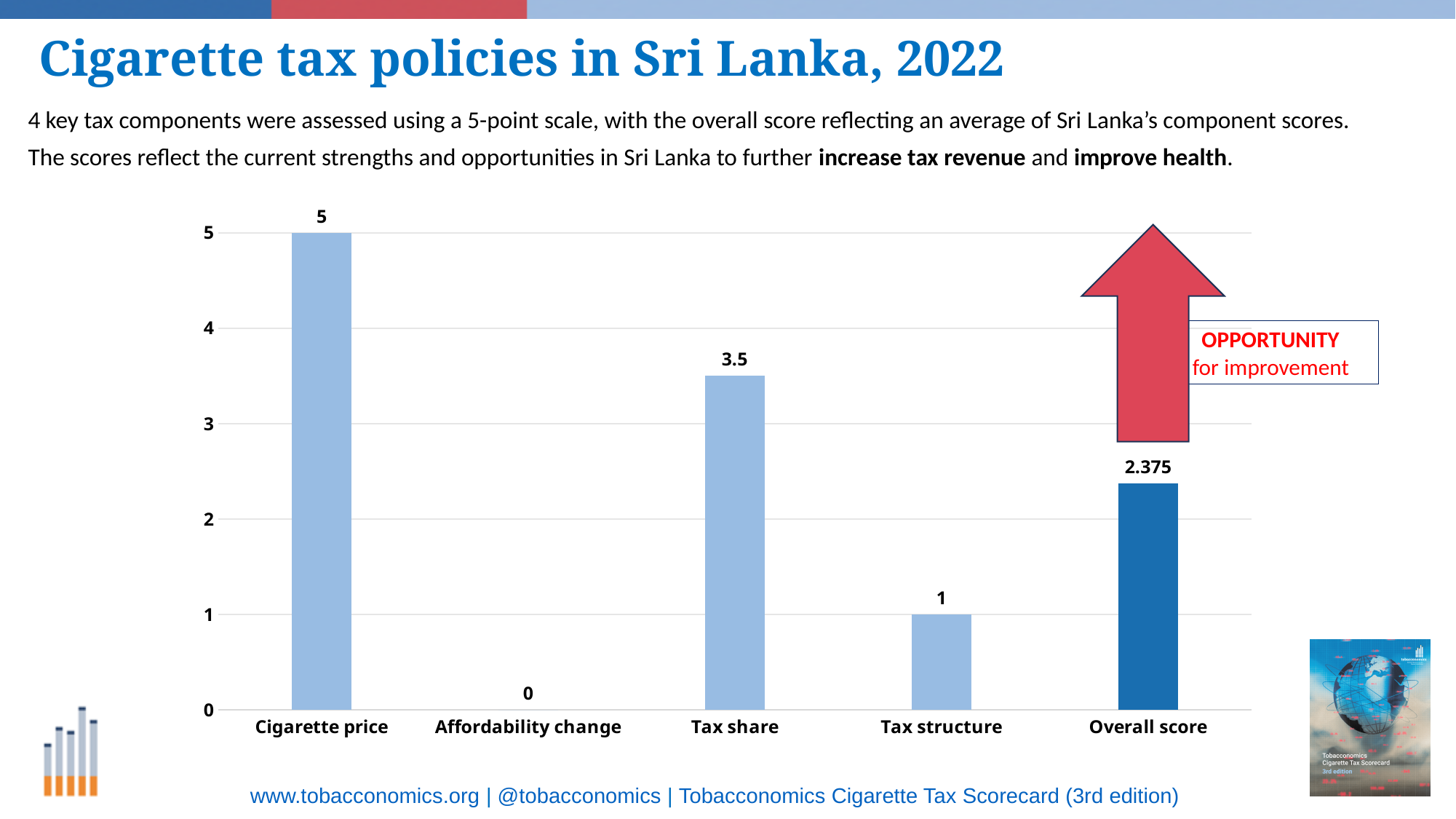
Which category has the highest score? Cigarette price How many categories are shown on the x axis? 5 Which is larger, the Tax share score or the Overall score? Tax share What is the score for Tax structure? 1 What is the score for Tax share? 3.5 What is the difference between the Cigarette price score and the Tax share score? 1.5 What is the Overall score? 2.375 What is the score for Affordability change? 0 What text is shown in the box next to the red arrow? OPPORTUNITY for improvement Which category has the lowest score? Affordability change What kind of chart is shown on the slide? Bar chart What is the score for Cigarette price? 5